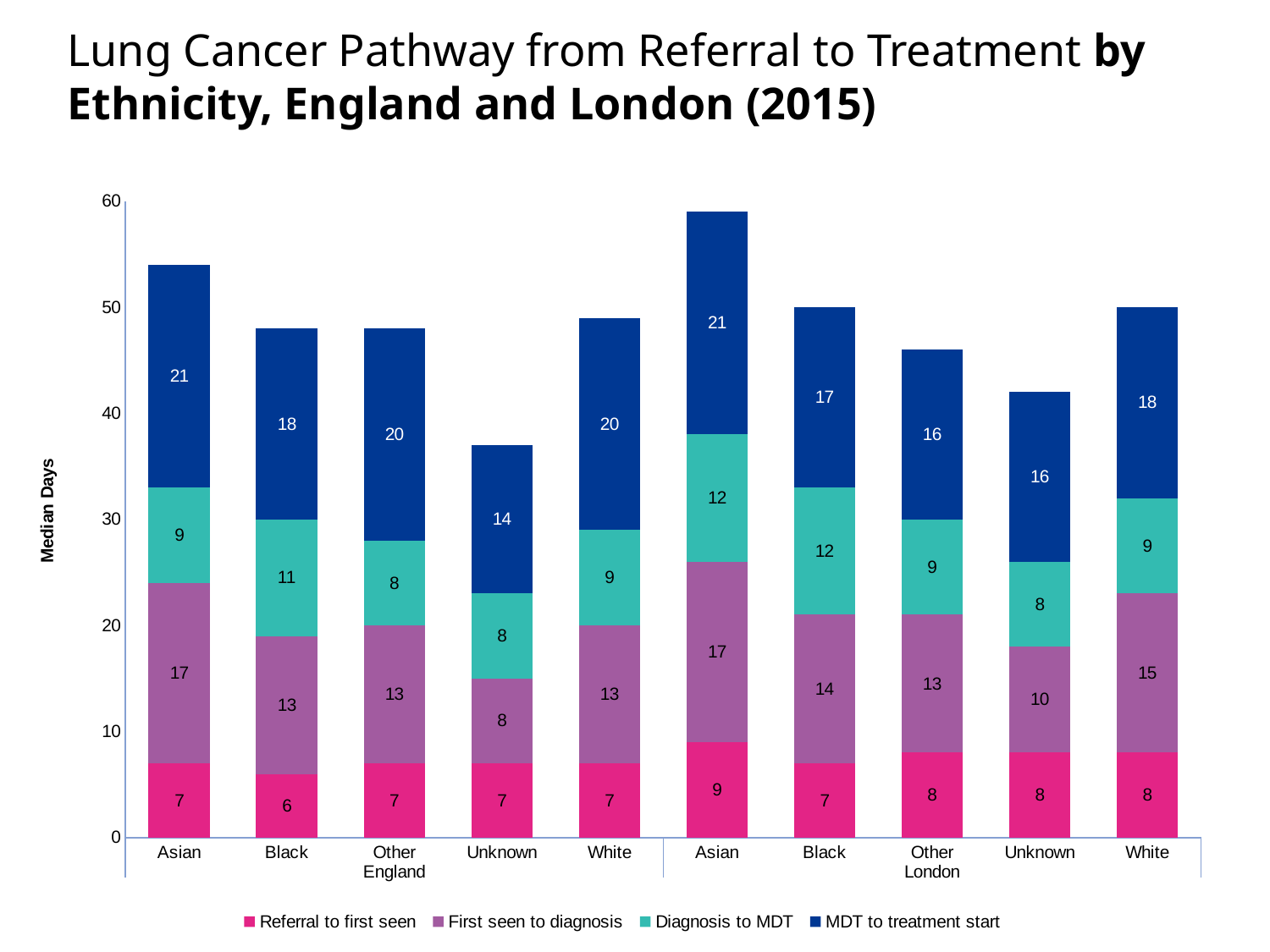
Which ethnicity group in London has the highest total median days from referral to treatment? Asian What is the total median number of days from referral to treatment for Unknown ethnicity patients in England? 37 What is the median number of days from diagnosis to MDT for Unknown ethnicity patients in London? 8 What is the total median number of days from referral to treatment for Asian patients in London? 59 What type of chart is shown on the slide? Stacked bar chart What is the median number of days from referral to first seen for Black patients in England? 6 Which ethnicity group in England has the lowest total median days from referral to treatment? Unknown Which is larger: the median days from diagnosis to MDT for Black patients in England or for Black patients in London? London What is the difference in median days from MDT to treatment start between Asian and Unknown patients in England? 7 How many series does the legend list? 4 What is the median number of days from first seen to diagnosis for White patients in London? 15 What is the median number of days from MDT to treatment start for Asian patients in England? 21